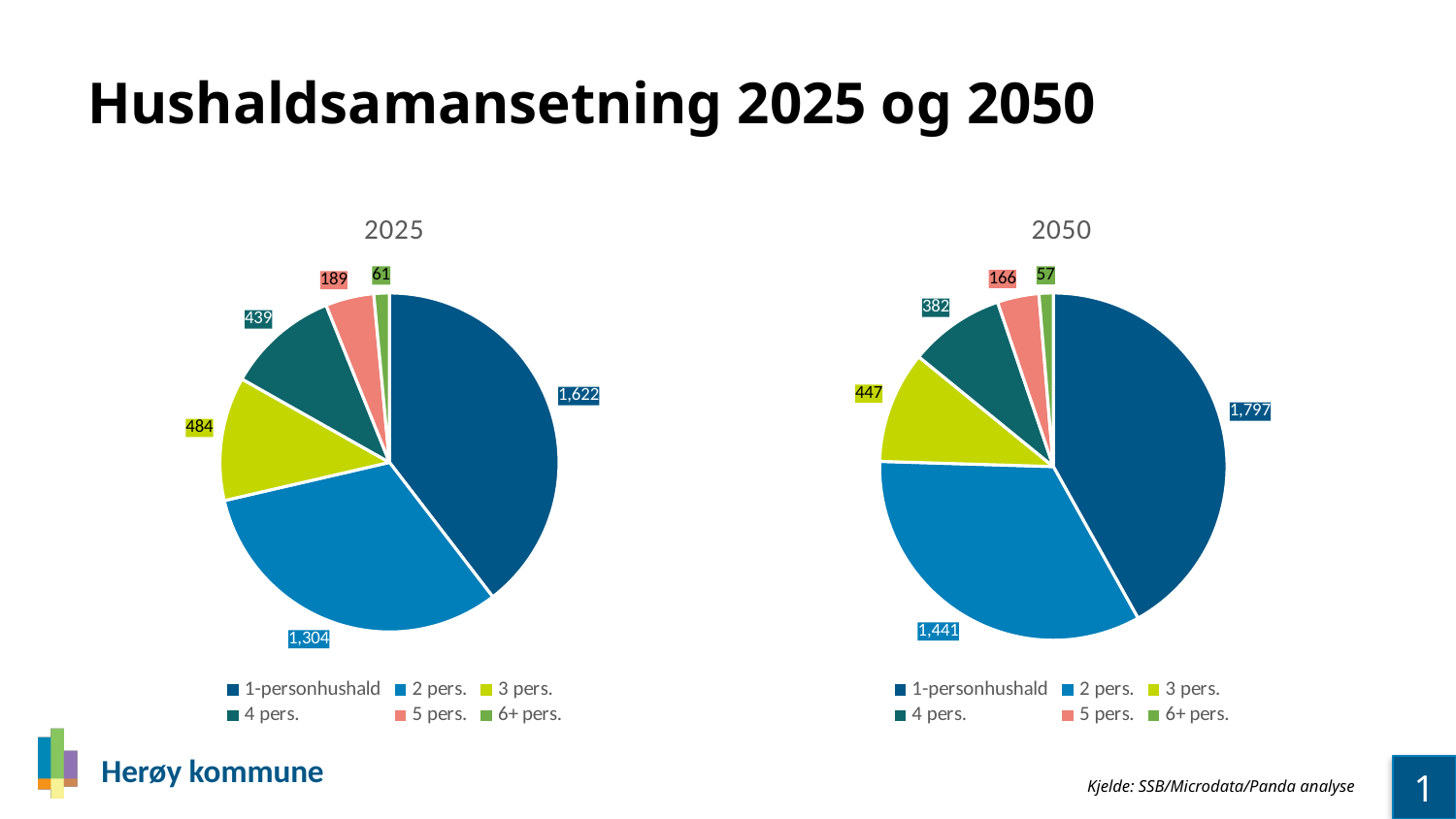
In the 2050 pie chart, what is the value for 6+ pers.? 57 In the 2025 pie chart, what is the difference between the values for 1-personhushald and 2 pers.? 318 How many categories does the 2050 pie chart show? 6 In the 2050 pie chart, what is the difference between the values for 3 pers. and 4 pers.? 65 What is the title of the slide? Hushaldsamansetning 2025 og 2050 What kind of chart is used for the 2025 data? Pie chart In the 2025 pie chart, which is larger: 3 pers. or 4 pers.? 3 pers. In the 2025 pie chart, what is the value for 5 pers.? 189 In the 2050 pie chart, which category has the largest slice? 1-personhushald In the 2050 pie chart, what is the value for 2 pers.? 1,441 In the 2025 pie chart, what is the value for 1-personhushald? 1,622 In the 2025 pie chart, which category has the smallest slice? 6+ pers.